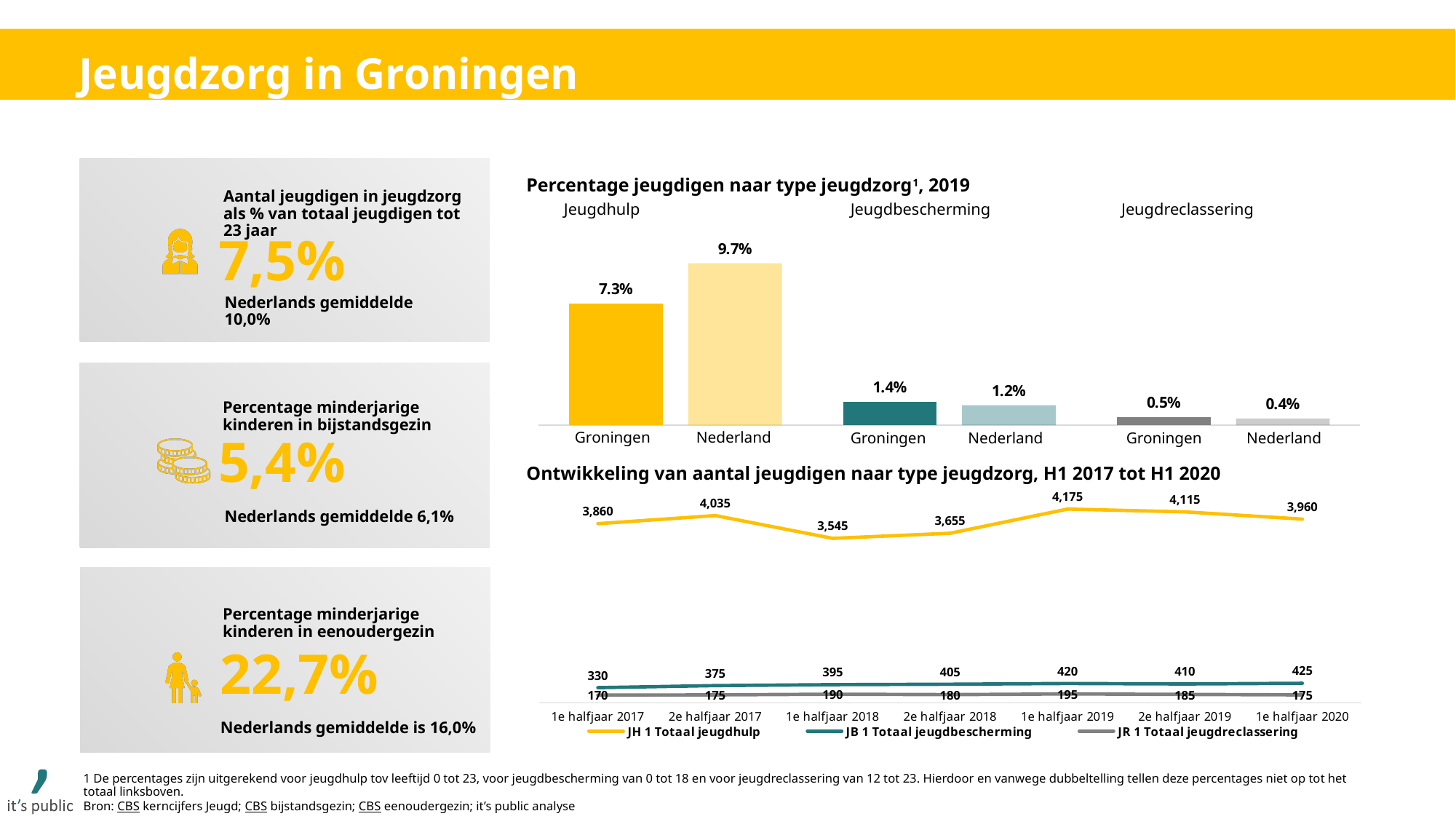
In the chart 'Ontwikkeling van aantal jeugdigen naar type jeugdzorg, H1 2017 tot H1 2020', what is the value of JH 1 Totaal jeugdhulp in 1e halfjaar 2019? 4,175 In the chart 'Percentage jeugdigen naar type jeugdzorg, 2019', what is the value for Groningen under Jeugdhulp? 7.3% In the chart 'Ontwikkeling van aantal jeugdigen naar type jeugdzorg, H1 2017 tot H1 2020', how many series does the legend list? 3 In the chart 'Percentage jeugdigen naar type jeugdzorg, 2019', which bar is the highest? Nederland (Jeugdhulp) In the chart 'Ontwikkeling van aantal jeugdigen naar type jeugdzorg, H1 2017 tot H1 2020', in which period is JH 1 Totaal jeugdhulp lowest? 1e halfjaar 2018 In the chart 'Ontwikkeling van aantal jeugdigen naar type jeugdzorg, H1 2017 tot H1 2020', what is the value of JR 1 Totaal jeugdreclassering in 2e halfjaar 2018? 180 In the chart 'Ontwikkeling van aantal jeugdigen naar type jeugdzorg, H1 2017 tot H1 2020', what is the difference in JB 1 Totaal jeugdbescherming between 1e halfjaar 2020 and 1e halfjaar 2017? 95 In the chart 'Percentage jeugdigen naar type jeugdzorg, 2019', which is larger under Jeugdreclassering: Groningen or Nederland? Groningen In the chart 'Percentage jeugdigen naar type jeugdzorg, 2019', what is the difference between Nederland and Groningen under Jeugdhulp? 2.4% In the chart 'Percentage jeugdigen naar type jeugdzorg, 2019', what is the value for Nederland under Jeugdbescherming? 1.2% In the chart 'Ontwikkeling van aantal jeugdigen naar type jeugdzorg, H1 2017 tot H1 2020', how many time periods are shown on the x axis? 7 What kind of chart is 'Percentage jeugdigen naar type jeugdzorg, 2019'? Bar chart